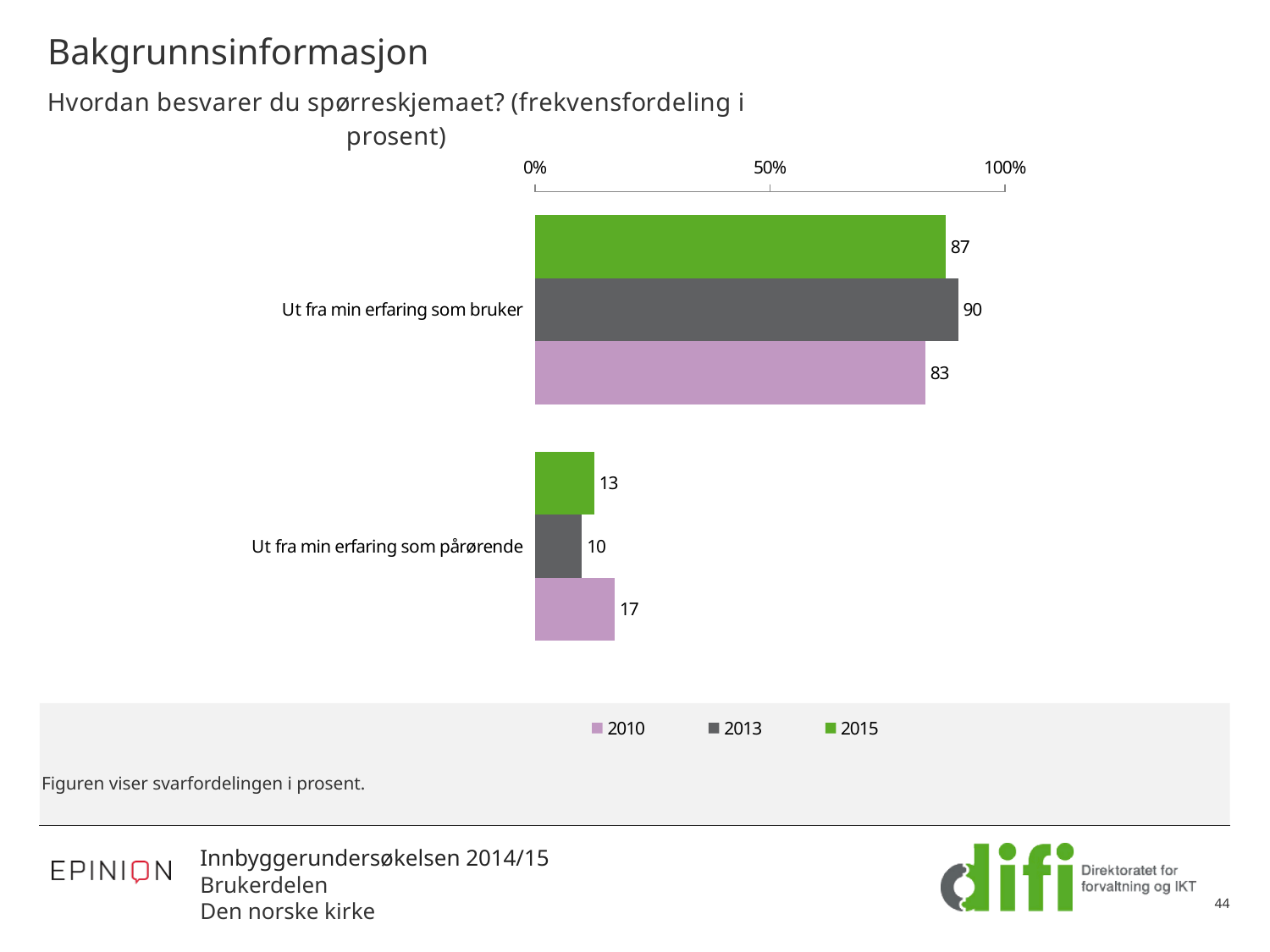
What is the value for 2013 in the category "Ut fra min erfaring som pårørende"? 10 What is the value for 2015 in the category "Ut fra min erfaring som bruker"? 87 What is the value for 2010 in the category "Ut fra min erfaring som pårørende"? 17 How many categories are shown on the chart? 2 How many series does the legend list? 3 Which year has the highest value for "Ut fra min erfaring som bruker"? 2013 Which is larger for "Ut fra min erfaring som pårørende": the 2015 value or the 2010 value? 2010 Which colour represents the 2015 series in the legend? Green What kind of chart is shown on the slide? Bar chart What is the value for 2013 in the category "Ut fra min erfaring som bruker"? 90 What is the difference between the 2013 and 2010 values for "Ut fra min erfaring som bruker"? 7 Which year has the lowest value for "Ut fra min erfaring som pårørende"? 2013